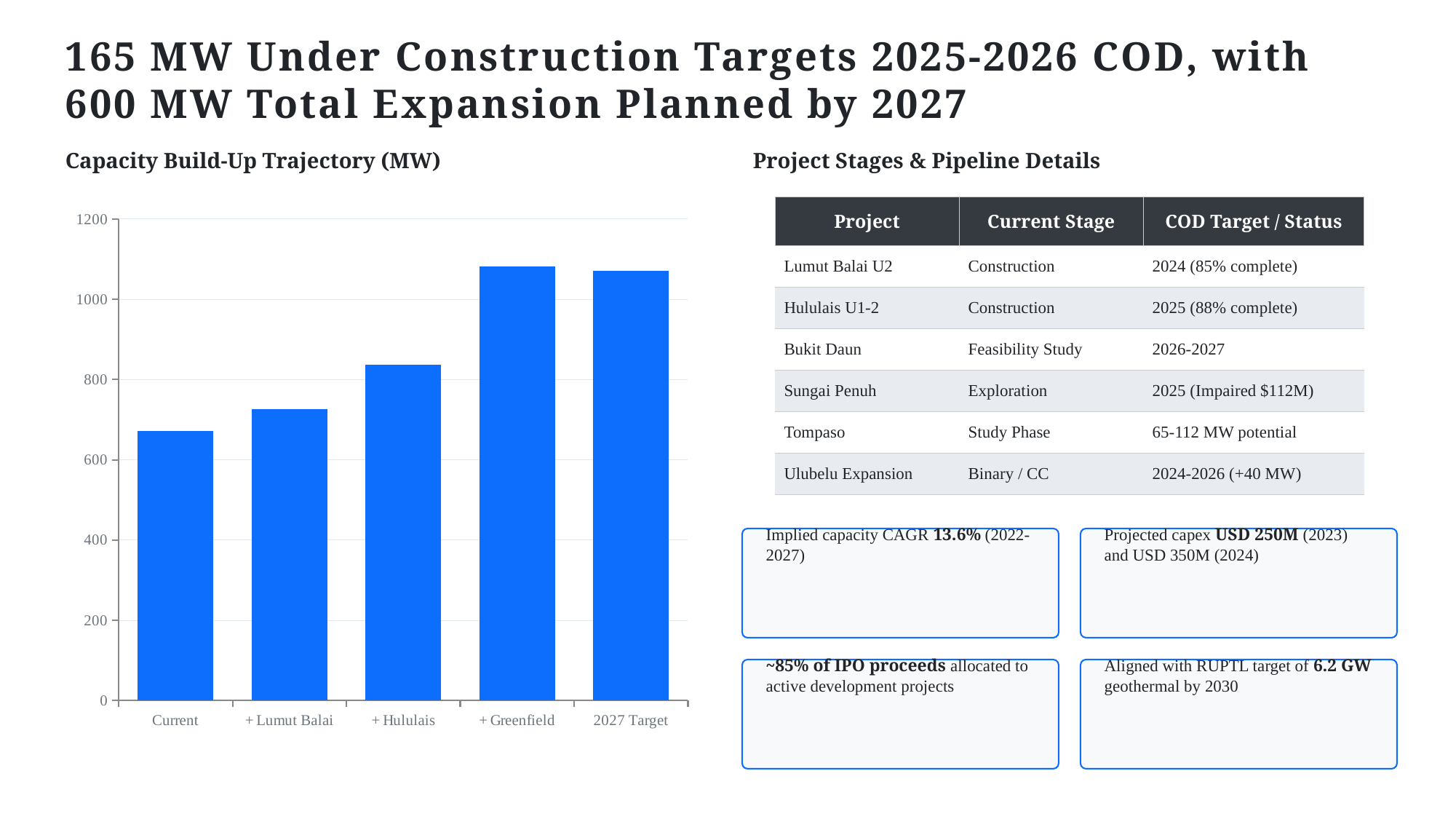
In the Capacity Build-Up Trajectory chart, is the value for + Greenfield greater or less than 1000? greater In the Capacity Build-Up Trajectory chart, do the values rise or fall from Current to + Greenfield? rise In the Capacity Build-Up Trajectory chart, is the value for + Lumut Balai greater or less than 800? less In the Capacity Build-Up Trajectory chart, is the value for Current greater or less than 600? greater How many categories are shown on the x axis of the Capacity Build-Up Trajectory chart? 5 Which category has the lowest value in the Capacity Build-Up Trajectory chart? Current In the Capacity Build-Up Trajectory chart, which is larger: the value for + Hululais or the value for + Lumut Balai? + Hululais What kind of chart is shown under "Capacity Build-Up Trajectory (MW)"? bar chart What is the title of the chart on the left of the slide? Capacity Build-Up Trajectory (MW)